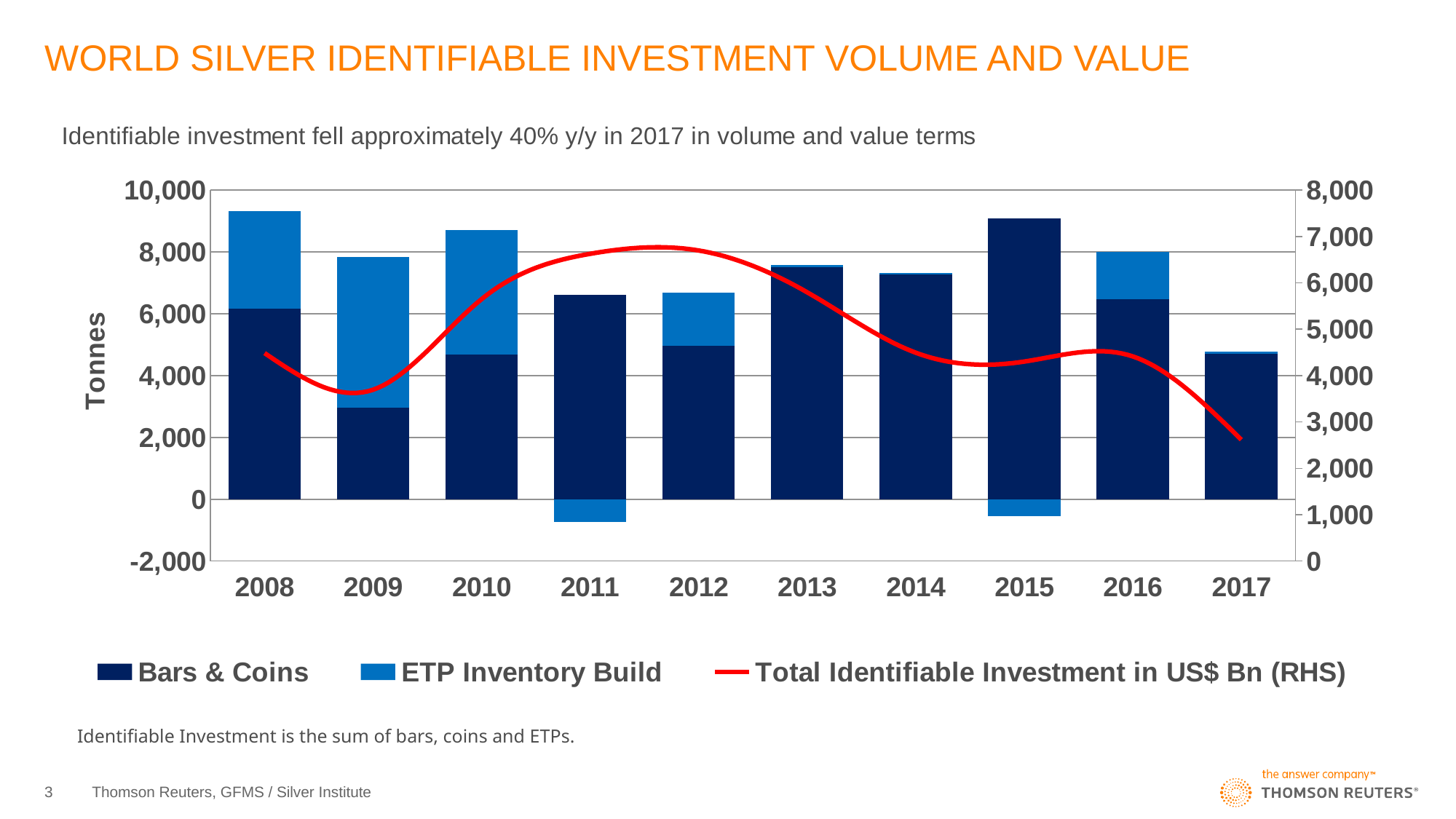
Does the Total Identifiable Investment in US$ Bn line rise or fall from 2012 to 2017? fall In which year is the Bars & Coins value highest? 2015 Which year has the larger Bars & Coins value, 2012 or 2013? 2013 How many series does the legend list? 3 Is the Total Identifiable Investment in US$ Bn for 2017 greater or less than 3,000 on the right-hand axis? less In which year is the Bars & Coins value lowest? 2009 In which year is the Total Identifiable Investment in US$ Bn line at its lowest? 2017 Is the Bars & Coins value for 2009 greater or less than 4,000 tonnes? less Is the Bars & Coins value for 2015 greater or less than 8,000 tonnes? greater What kind of chart is shown on the slide? bar chart with a line How many years are shown on the x axis? 10 What is the label on the left vertical axis? Tonnes